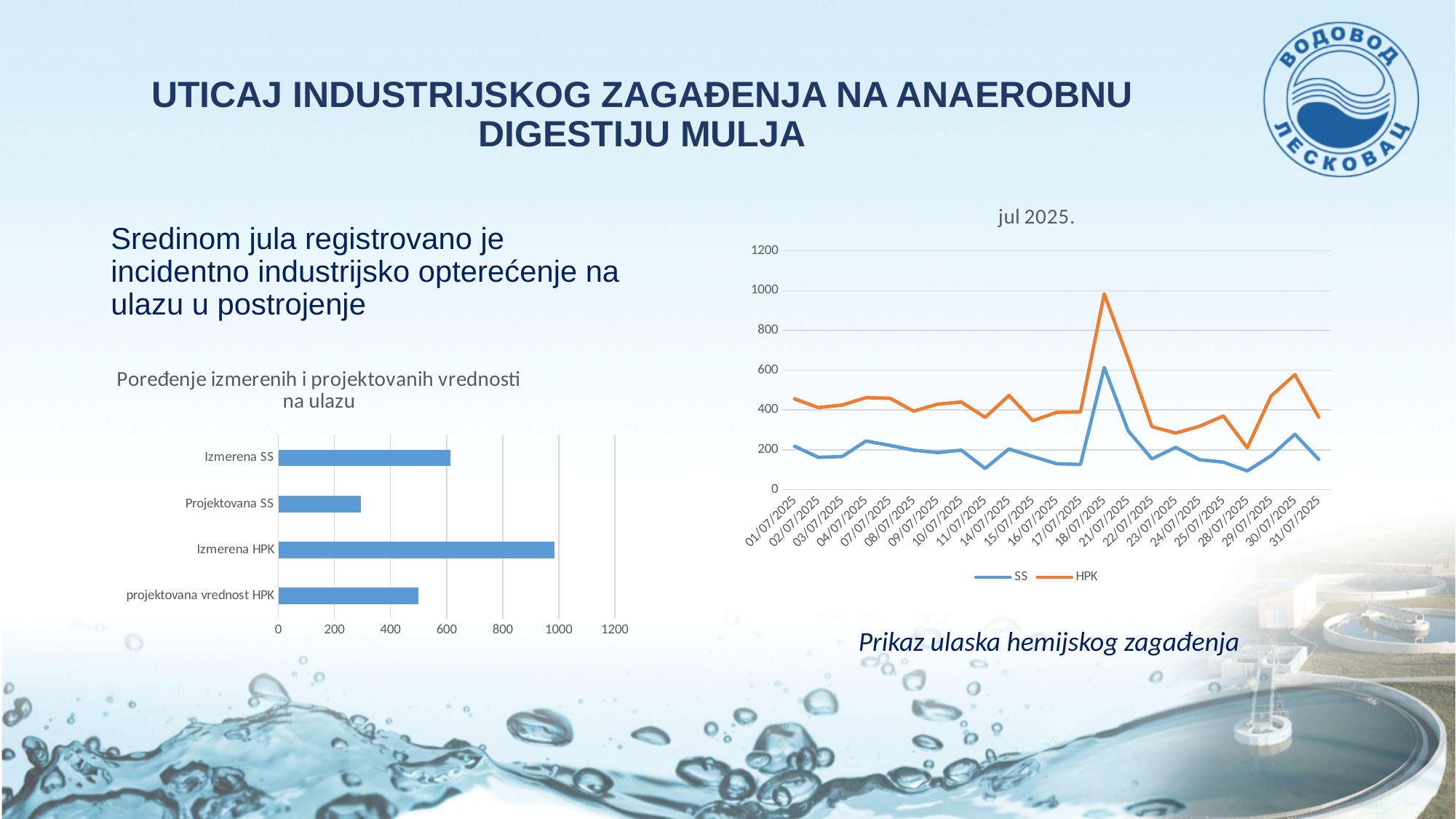
In the chart titled 'Poređenje izmerenih i projektovanih vrednosti na ulazu', is the value for Izmerena HPK greater or less than 800? greater In the chart titled 'Poređenje izmerenih i projektovanih vrednosti na ulazu', is the value for Projektovana SS greater or less than 400? less In the chart titled 'Poređenje izmerenih i projektovanih vrednosti na ulazu', which category has the highest value? Izmerena HPK In the chart titled 'Poređenje izmerenih i projektovanih vrednosti na ulazu', which category has the lowest value? Projektovana SS What kind of chart is the chart titled 'Poređenje izmerenih i projektovanih vrednosti na ulazu'? bar chart What are the two series named in the legend of the chart titled 'jul 2025.'? SS and HPK What kind of chart is the chart titled 'jul 2025.'? line chart In the chart titled 'jul 2025.', on which date does the HPK series reach its highest value? 18/07/2025 How many series does the legend of the chart titled 'jul 2025.' list? 2 How many categories are shown in the chart titled 'Poređenje izmerenih i projektovanih vrednosti na ulazu'? 4 In the chart titled 'jul 2025.', is the HPK value on 18/07/2025 greater or less than 800? greater In the chart titled 'Poređenje izmerenih i projektovanih vrednosti na ulazu', which is larger: Izmerena SS or projektovana vrednost HPK? Izmerena SS